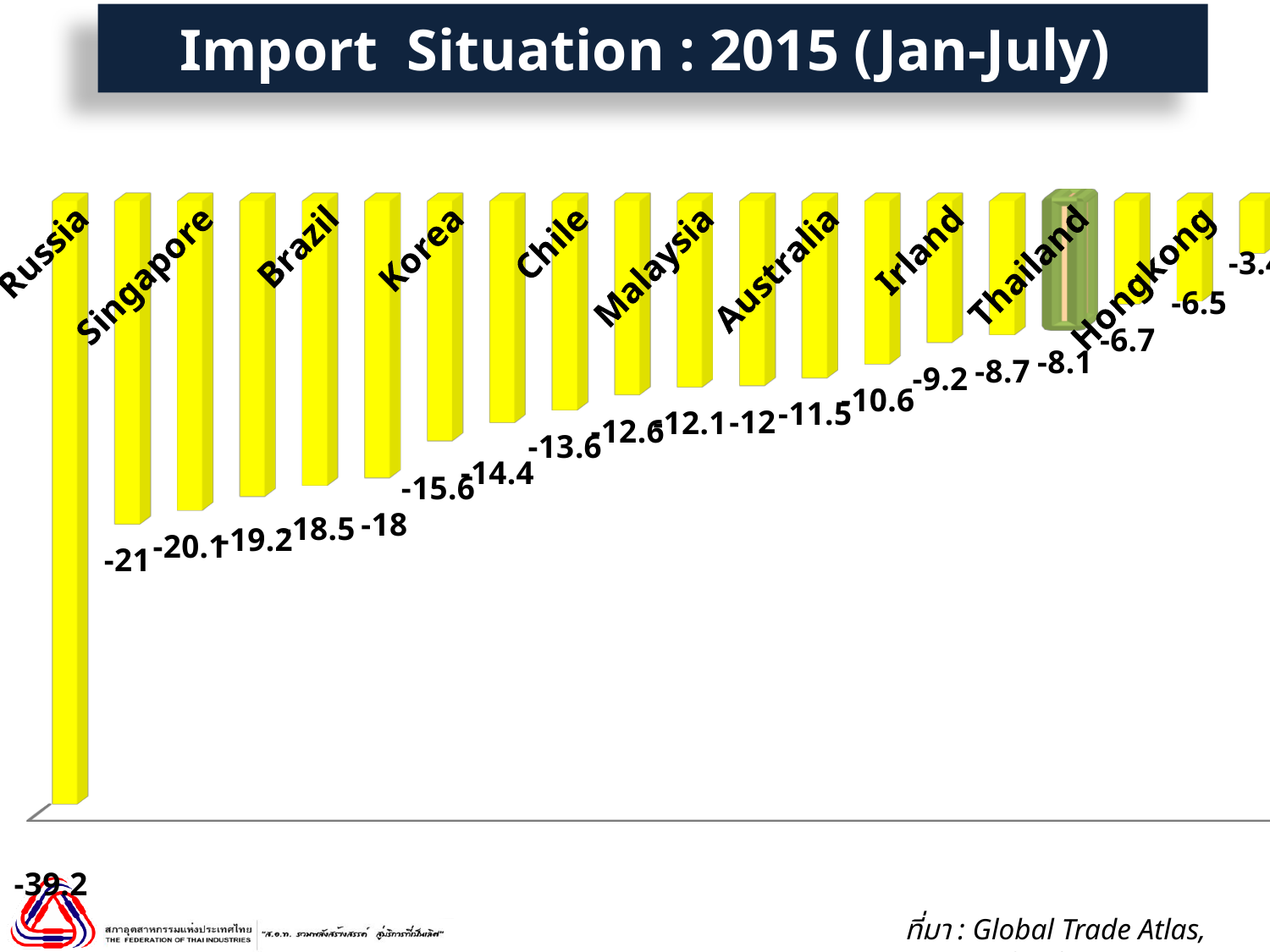
What is the value shown for Russia? -39.2 What is the value shown for Singapore? -20.1 What is the title of the chart on the slide? Import Situation : 2015 (Jan-July) What kind of chart is shown on the slide? Bar chart What is the difference between the values for Russia and Singapore? 19.1 Do the values rise or fall moving from left to right along the chart? Rise Which country shows the larger decline, Russia or Singapore? Russia What is the value shown for Thailand, the highlighted bar? -8.1 Which country's bar is highlighted in green instead of yellow? Thailand Which country has the lowest (most negative) value in the chart? Russia What is the difference between the values for Russia and Thailand? 31.1